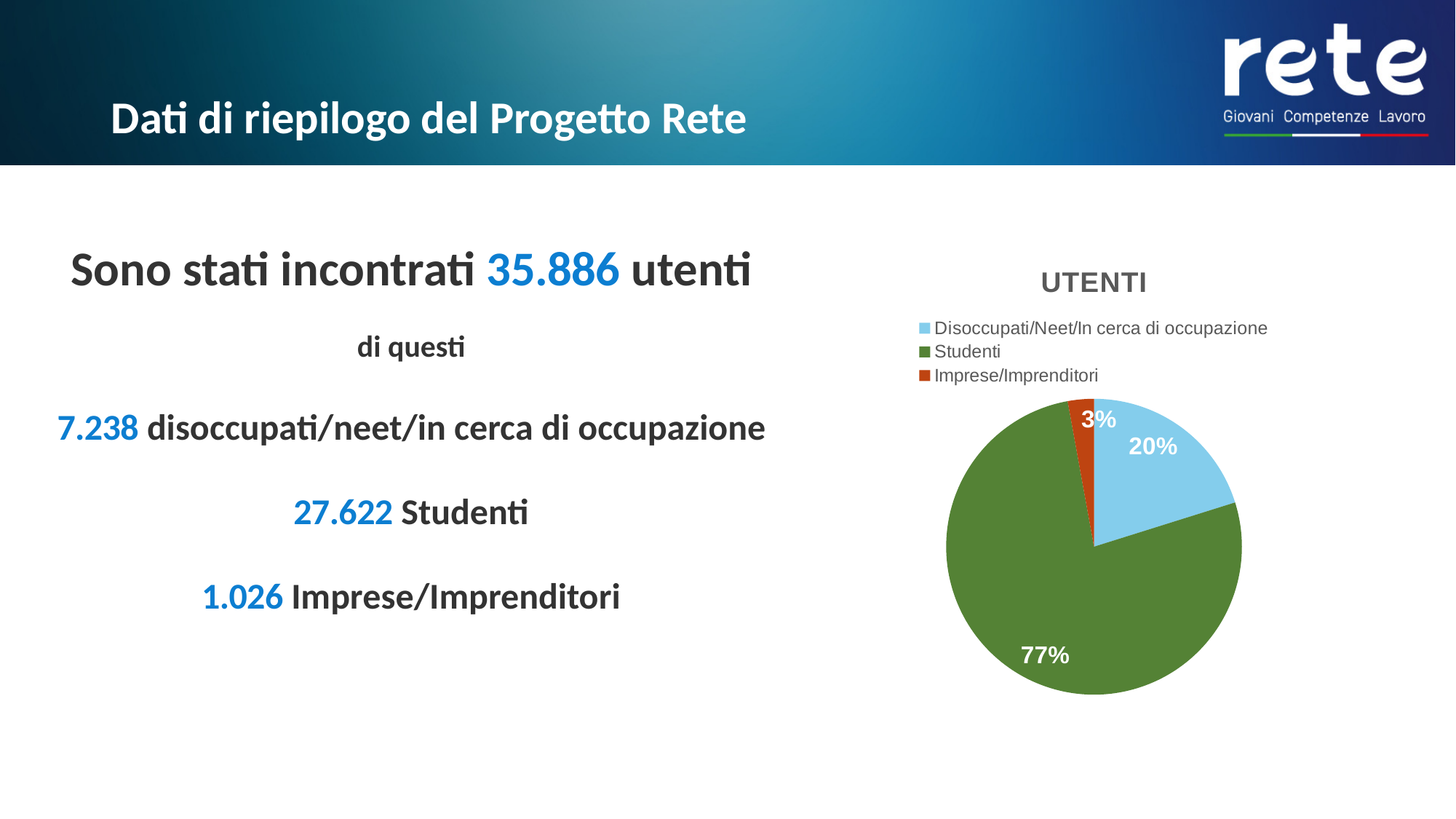
Which category has the smallest slice of the pie? Imprese/Imprenditori What is the title of the chart? UTENTI What share of the pie does Imprese/Imprenditori represent? 3% What is the difference in percentage points between the Studenti slice and the Disoccupati/Neet/In cerca di occupazione slice? 57 What kind of chart is shown on the slide? pie chart How many entries does the chart legend list? 3 What share of the pie does Disoccupati/Neet/In cerca di occupazione represent? 20% How many slices does the pie chart have? 3 What colour is the Studenti slice in the pie chart? green What share of the pie does Studenti represent? 77% Which category has the largest slice of the pie? Studenti Which slice is larger: Disoccupati/Neet/In cerca di occupazione or Imprese/Imprenditori? Disoccupati/Neet/In cerca di occupazione